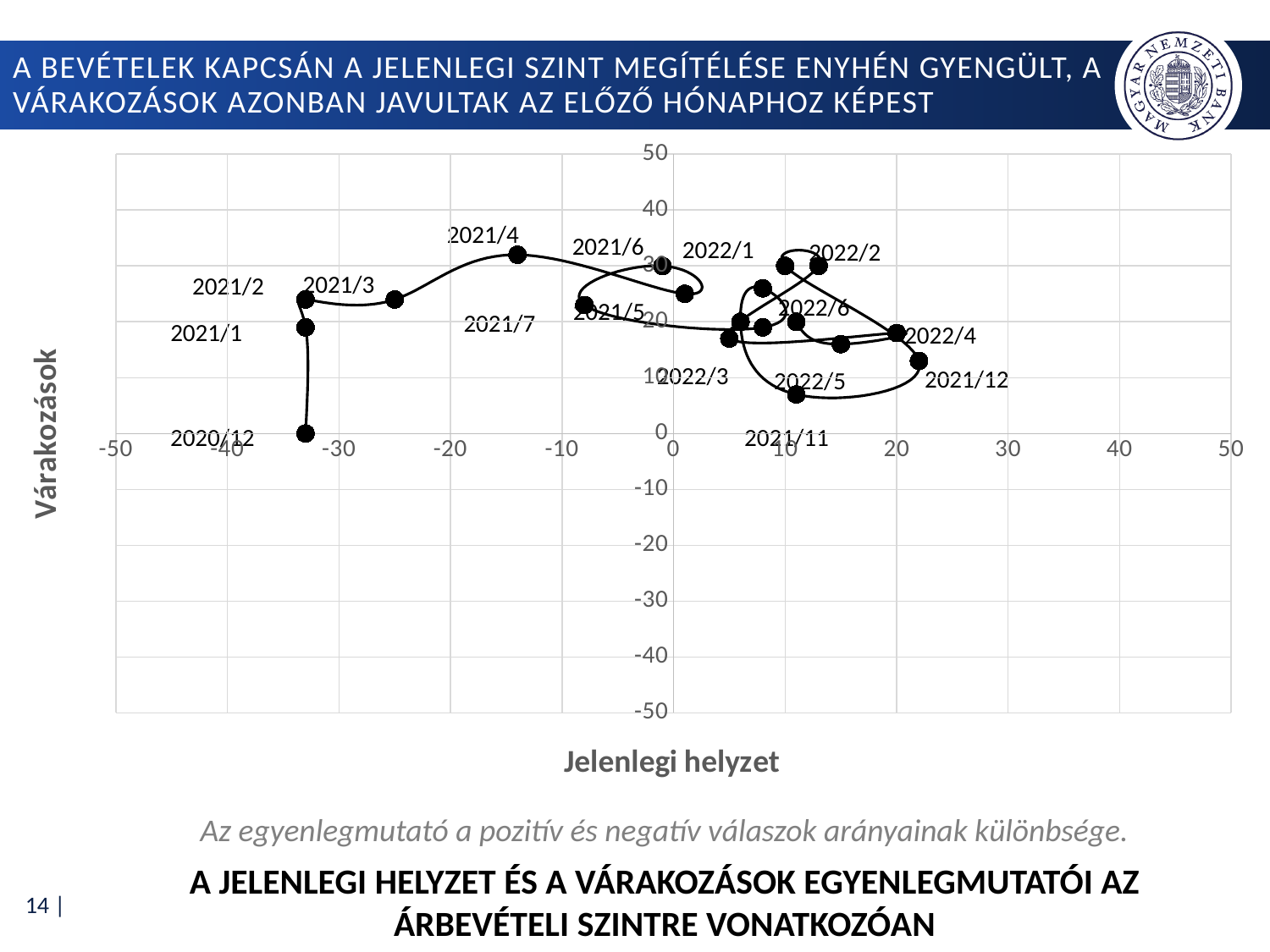
Which point has the higher Jelenlegi helyzet (horizontal) value, 2021/3 or 2021/4? 2021/4 What is the title of the vertical axis of the chart? Várakozások What kind of chart is shown on the slide? scatter chart Is the Várakozások (vertical) value for the point labelled 2020/12 greater or less than 10? less Which point has the higher Várakozások (vertical) value, 2021/4 or 2020/12? 2021/4 What is the title of the horizontal axis of the chart? Jelenlegi helyzet Is the Jelenlegi helyzet (horizontal) value for the point labelled 2022/4 greater or less than 10? greater Is the Jelenlegi helyzet (horizontal) value for the point labelled 2021/3 greater or less than -20? less Which labelled point has the lowest Várakozások (vertical) value? 2020/12